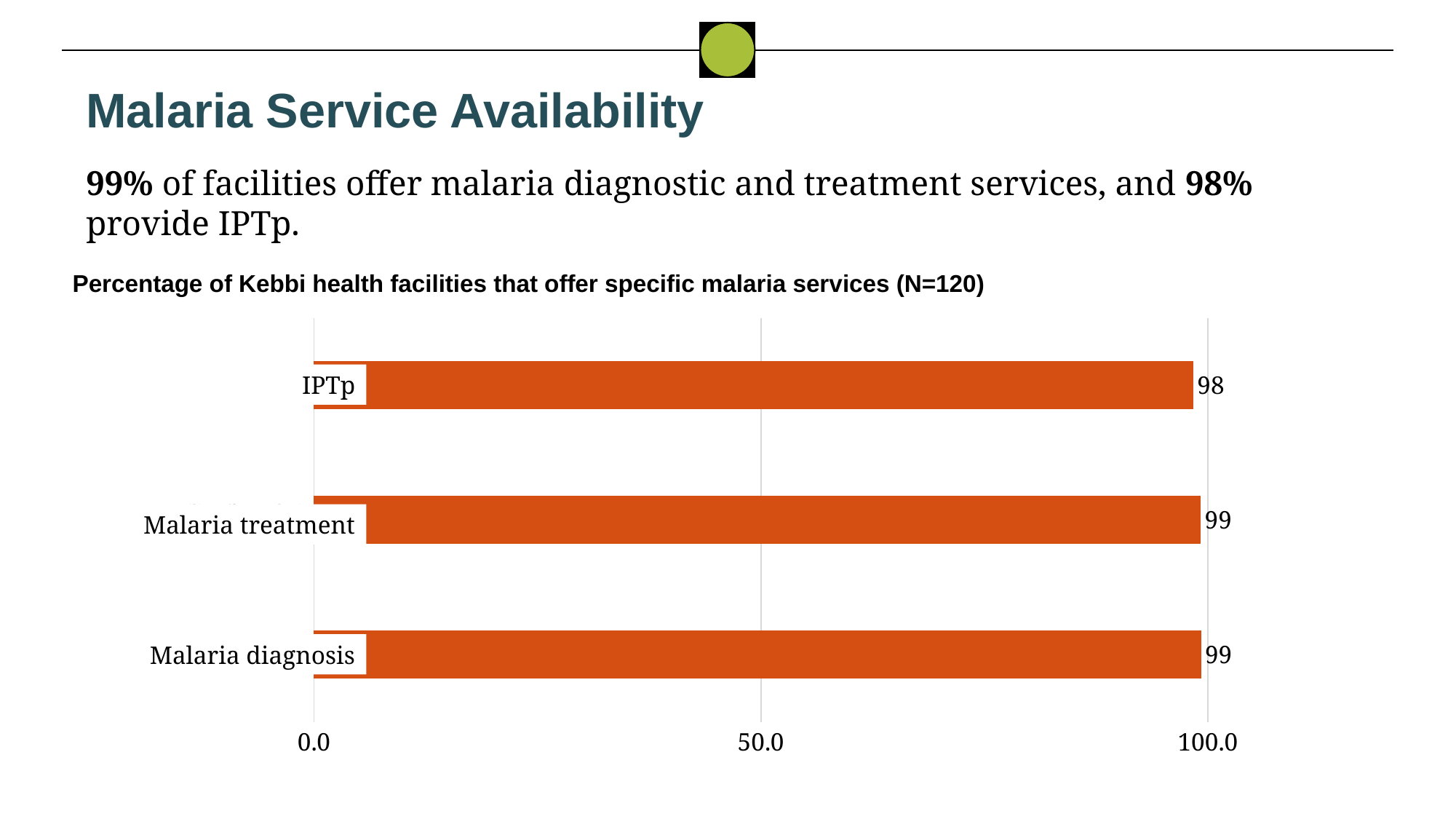
What kind of chart is shown on the slide? Bar chart Which category has the lowest value? IPTp What is the highest tick value shown on the x axis? 100.0 Is the value for IPTp greater or less than 50.0? greater What is the value for Malaria diagnosis? 99 What is the value for Malaria treatment? 99 Which is larger, the value for Malaria treatment or the value for IPTp? Malaria treatment How many categories are shown in the chart? 3 What is the difference between the values for Malaria diagnosis and IPTp? 1 What is the title of the chart? Percentage of Kebbi health facilities that offer specific malaria services (N=120) What is the value for IPTp? 98